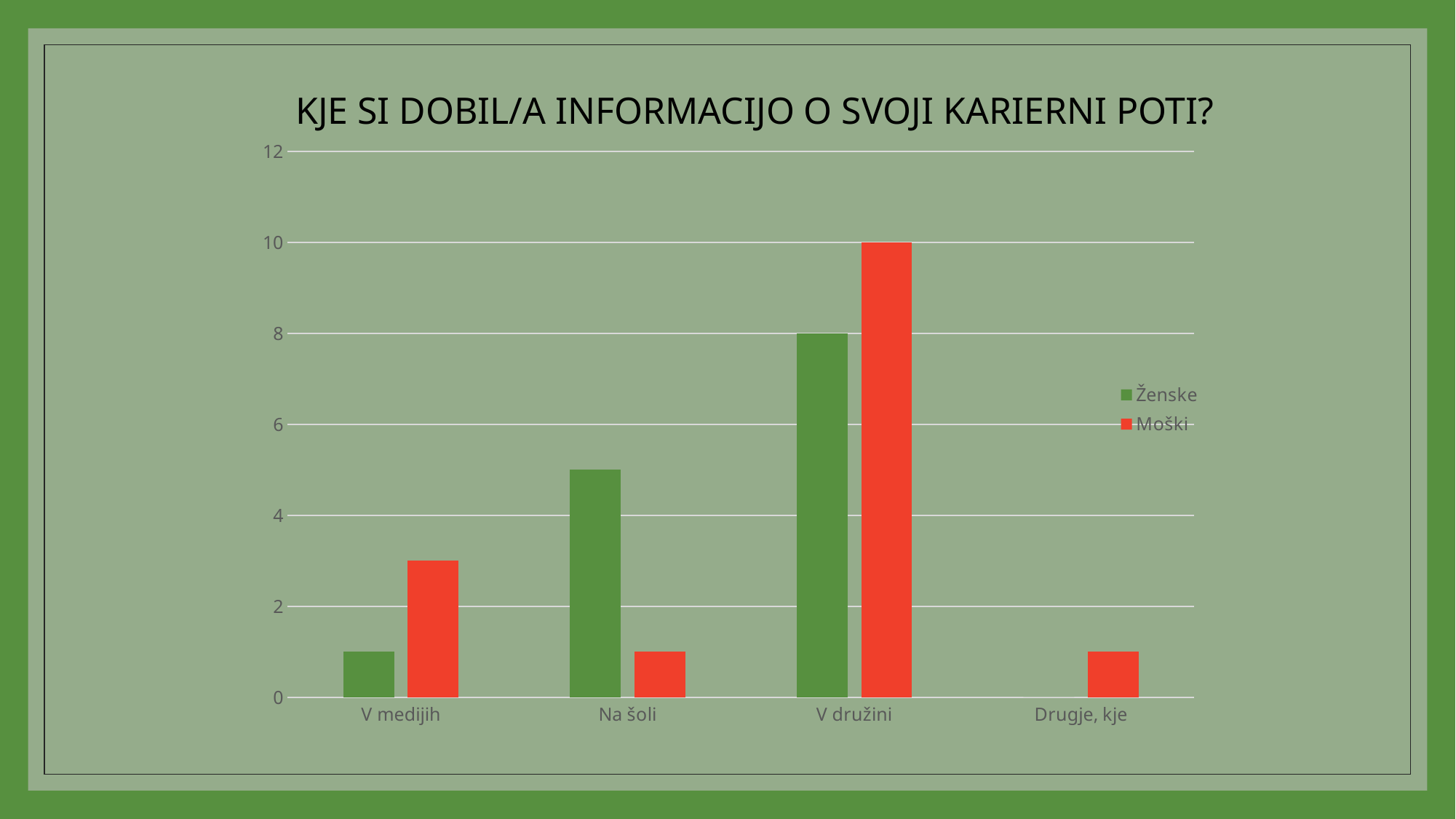
How many categories are shown on the x axis? 4 What is the title of the chart? KJE SI DOBIL/A INFORMACIJO O SVOJI KARIERNI POTI? Is the value for Ženske in the category Na šoli greater or less than 4? greater What kind of chart is shown on the slide? bar chart In which category is the Ženske value lowest? Drugje, kje In which category is the Moški value highest? V družini Which colour represents the Moški series in the legend? red What is the value for Ženske in the category V družini? 8 What is the value for Moški in the category V družini? 10 In the category Na šoli, which series has the larger value, Ženske or Moški? Ženske What is the difference between the Moški and Ženske values in the category V družini? 2 How many series does the legend list? 2